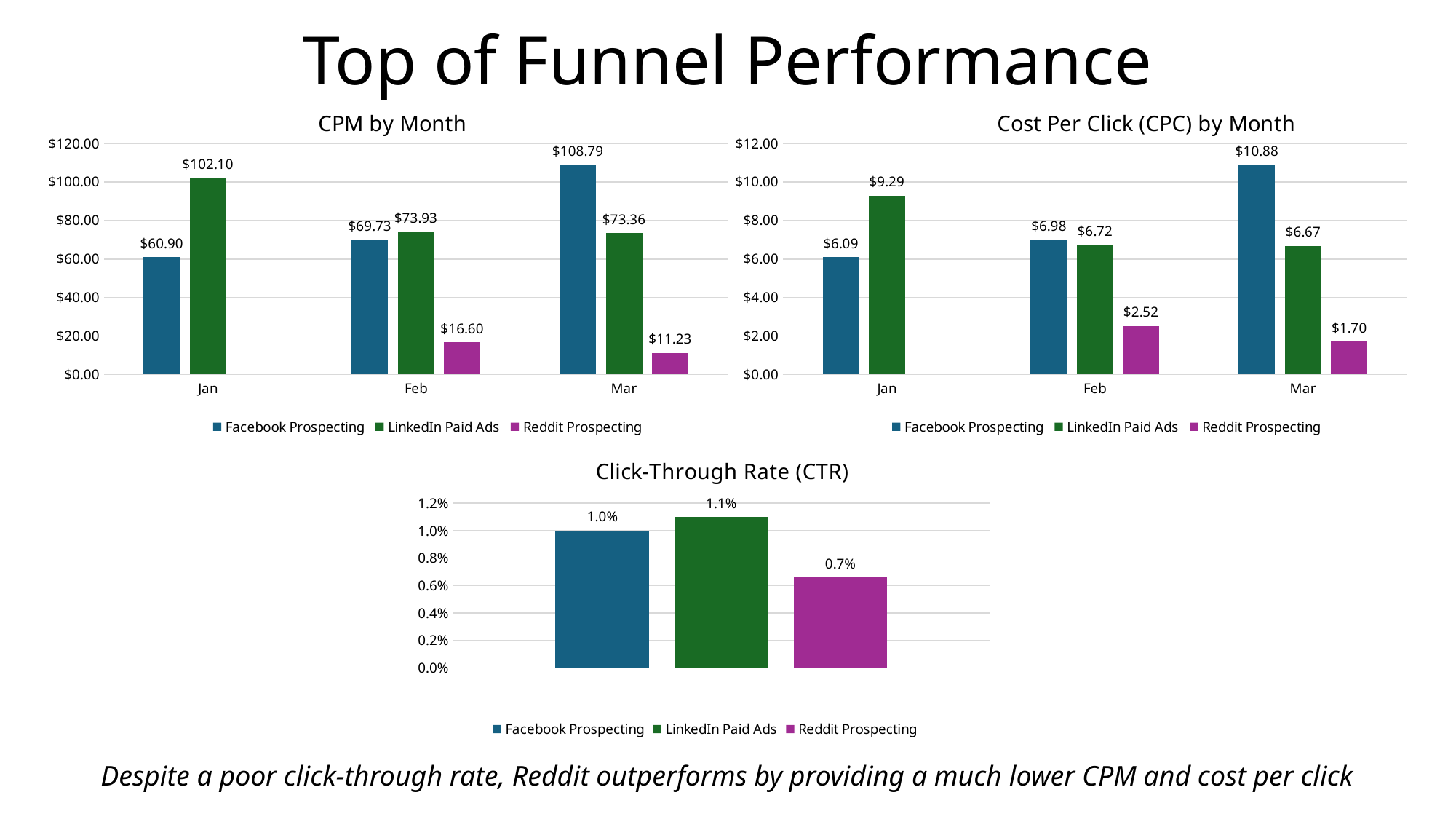
In the 'Cost Per Click (CPC) by Month' chart, which is larger: Facebook Prospecting in Feb or LinkedIn Paid Ads in Feb? Facebook Prospecting How many months are shown on the x axis of the 'Cost Per Click (CPC) by Month' chart? 3 In the 'CPM by Month' chart, which series has the highest CPM in Mar? Facebook Prospecting In the 'Click-Through Rate (CTR)' chart, which series has the highest CTR? LinkedIn Paid Ads In the 'Click-Through Rate (CTR)' chart, what is the CTR for Reddit Prospecting? 0.7% In the 'Cost Per Click (CPC) by Month' chart, which series has the lowest CPC in Feb? Reddit Prospecting In the 'Cost Per Click (CPC) by Month' chart, what is the CPC for Reddit Prospecting in Mar? $1.70 What kind of chart is the 'Click-Through Rate (CTR)' chart? Bar chart How many series does the legend of the 'CPM by Month' chart list? 3 In the 'CPM by Month' chart, what is the difference between the Facebook Prospecting and Reddit Prospecting CPM in Feb? $53.13 In the 'CPM by Month' chart, what is the CPM for LinkedIn Paid Ads in Jan? $102.10 In the 'Cost Per Click (CPC) by Month' chart, is the CPC for Facebook Prospecting in Jan greater or less than $8.00? less